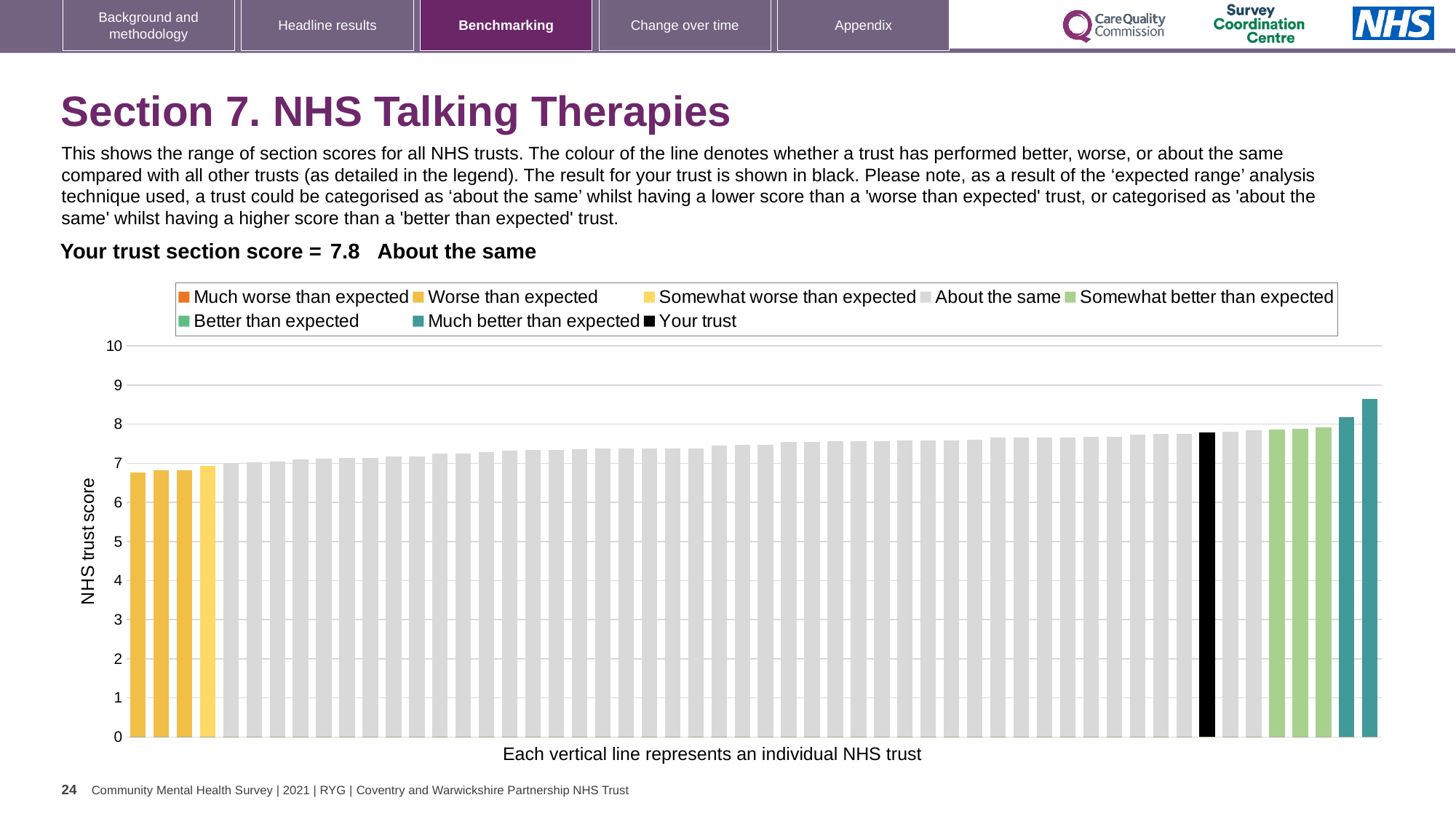
How many bars are coloured teal (Much better than expected)? 2 What is the label on the y axis of the chart? NHS trust score What kind of chart is shown on the slide? bar chart Which legend category does the highest bar on the chart belong to? Much better than expected Which is larger: the value for your trust (black bar) or the value of the leftmost bar? your trust How many entries does the chart legend list? 8 Is the value for your trust (the black bar) greater or less than 7? greater Is the value of the rightmost bar greater or less than 8? greater What is the section score for your trust shown on the slide? 7.8 Is the value of the leftmost bar greater or less than 7? less Do the bar values rise or fall moving from left to right along the x axis? rise What colour is the bar representing your trust? black